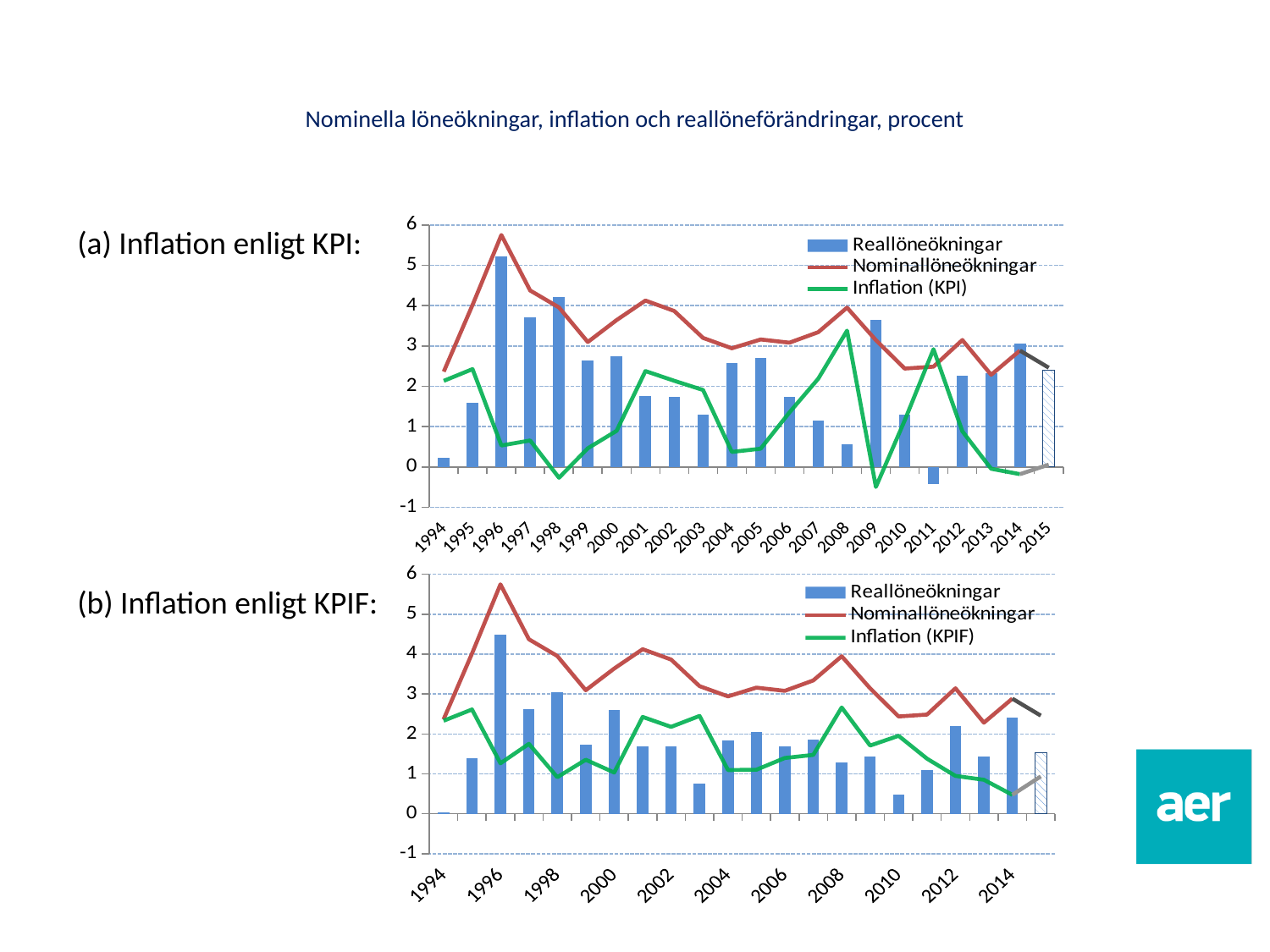
In chart (a) Inflation enligt KPI, is the Reallöneökningar value for 1996 greater or less than 4? greater In chart (b) Inflation enligt KPIF, which is larger in 2008: the Inflation (KPIF) value or the Reallöneökningar value? Inflation (KPIF) In chart (b) Inflation enligt KPIF, is the Reallöneökningar value for 1996 greater or less than 4? greater In chart (a) Inflation enligt KPI, in which year does the Nominallöneökningar line reach its peak? 1996 In chart (a) Inflation enligt KPI, which year has the lowest Reallöneökningar bar? 2011 In chart (a) Inflation enligt KPI, in which year is the Inflation (KPI) line at its lowest? 2009 In chart (a) Inflation enligt KPI, is the Reallöneökningar value for 2011 greater or less than 0? less What kind of chart is chart (a) Inflation enligt KPI? Combined bar and line chart In chart (a) Inflation enligt KPI, which series is drawn as bars? Reallöneökningar In chart (a) Inflation enligt KPI, which year has the highest Reallöneökningar bar? 1996 How many series does the legend of chart (a) Inflation enligt KPI list? 3 In chart (b) Inflation enligt KPIF, what colour is the Inflation (KPIF) line? Green